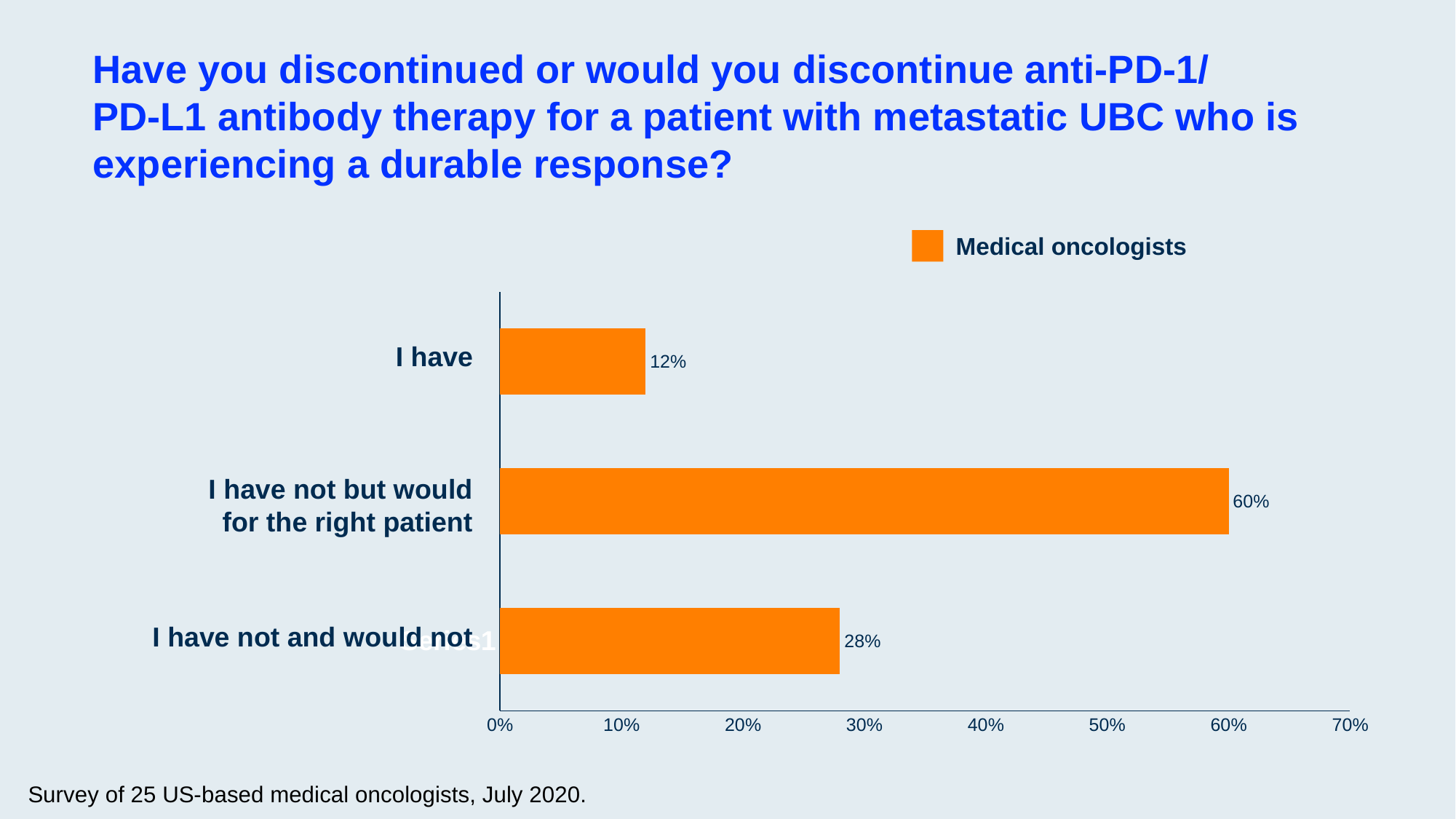
What series does the legend list? Medical oncologists Which response category has the lowest percentage? I have How many response categories are shown in the chart? 3 Which is larger: the percentage for "I have" or for "I have not and would not"? I have not and would not What percentage of medical oncologists answered "I have not but would for the right patient"? 60% What is the difference in percentage points between "I have not but would for the right patient" and "I have not and would not"? 32 percentage points What percentage of medical oncologists answered "I have"? 12% What percentage of medical oncologists answered "I have not and would not"? 28% What is the difference in percentage points between "I have not and would not" and "I have"? 16 percentage points What type of chart is shown on the slide? Bar chart Which response category has the highest percentage? I have not but would for the right patient Is the value for "I have not but would for the right patient" greater or less than 50%? greater